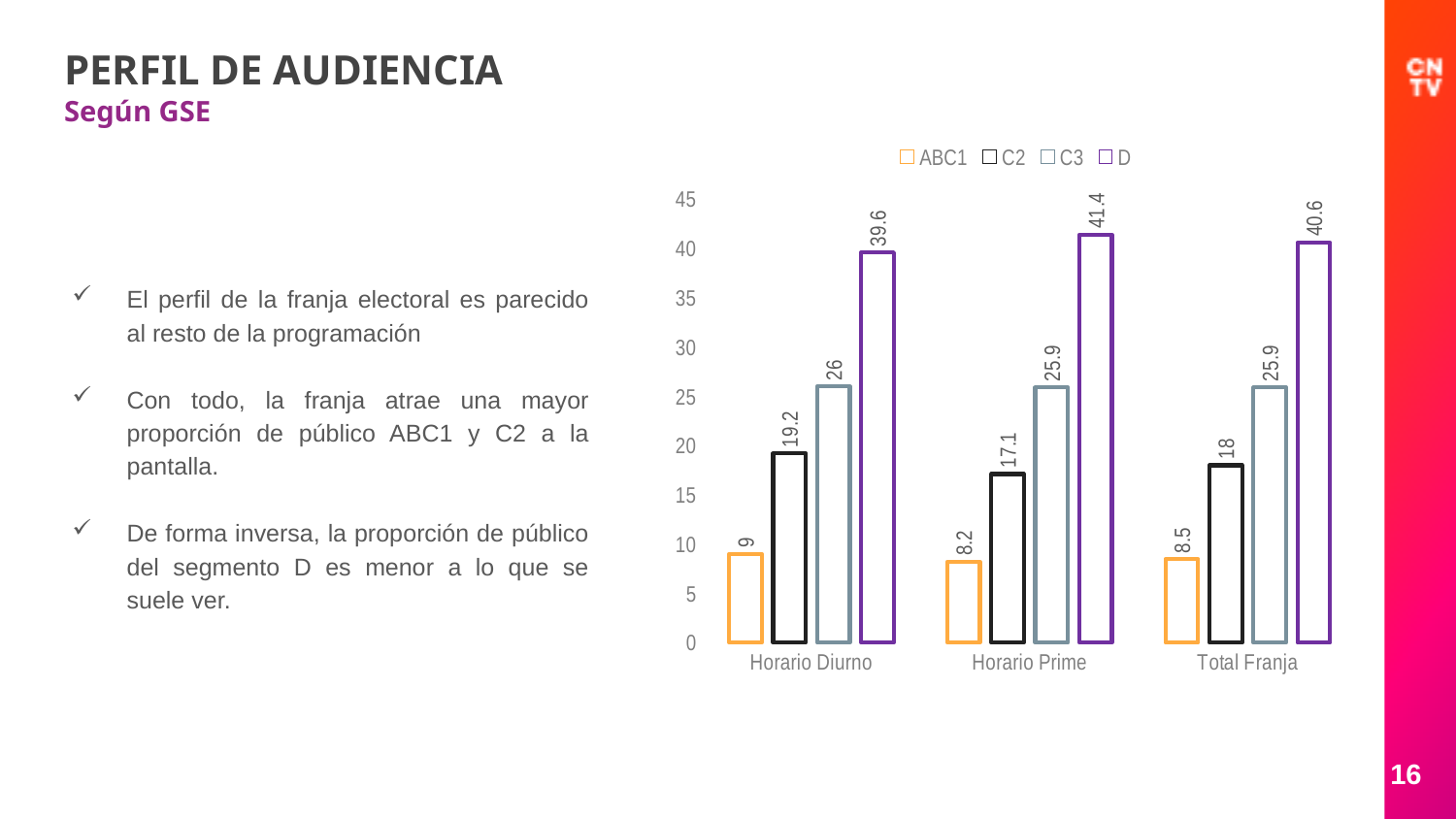
What is the value for ABC1 in Total Franja? 8.5 What is the value for D in Horario Prime? 41.4 What is the difference between the D value and the C3 value in Horario Diurno? 13.6 What is the value for C2 in Horario Diurno? 19.2 Which series has the highest value in Horario Diurno? D How many categories are shown on the x axis? 3 What is the value for C3 in Horario Prime? 25.9 What is the difference between the ABC1 value in Horario Diurno and the ABC1 value in Horario Prime? 0.8 How many series does the legend list? 4 What kind of chart is shown on the slide? Bar chart Which series has the lowest value in Total Franja? ABC1 Which is larger, the C2 value in Horario Diurno or the C2 value in Horario Prime? Horario Diurno